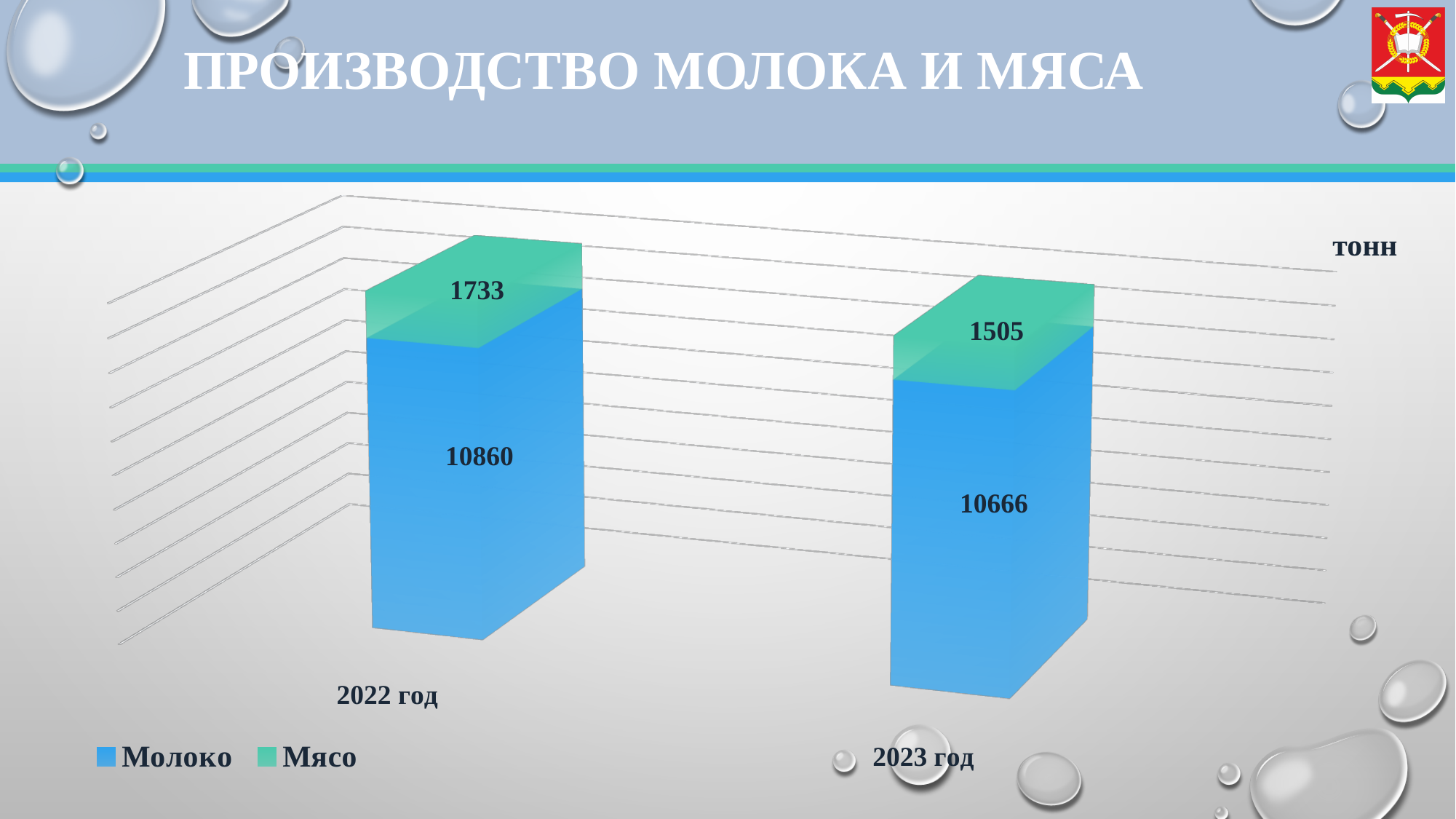
What is the value for Мясо in 2022 год? 1733 What is the value for Молоко in 2022 год? 10860 What kind of chart is shown on the slide? Stacked bar chart What is the value for Мясо in 2023 год? 1505 How many series does the legend list? 2 What is the total of the stacked bar for 2022 год? 12593 What is the difference between the Мясо values for 2022 год and 2023 год? 228 What is the difference between the Молоко values for 2022 год and 2023 год? 194 Which year has the lower value for Мясо? 2023 год Which year has the higher value for Молоко? 2022 год What is the value for Молоко in 2023 год? 10666 What is the total of the stacked bar for 2023 год? 12171